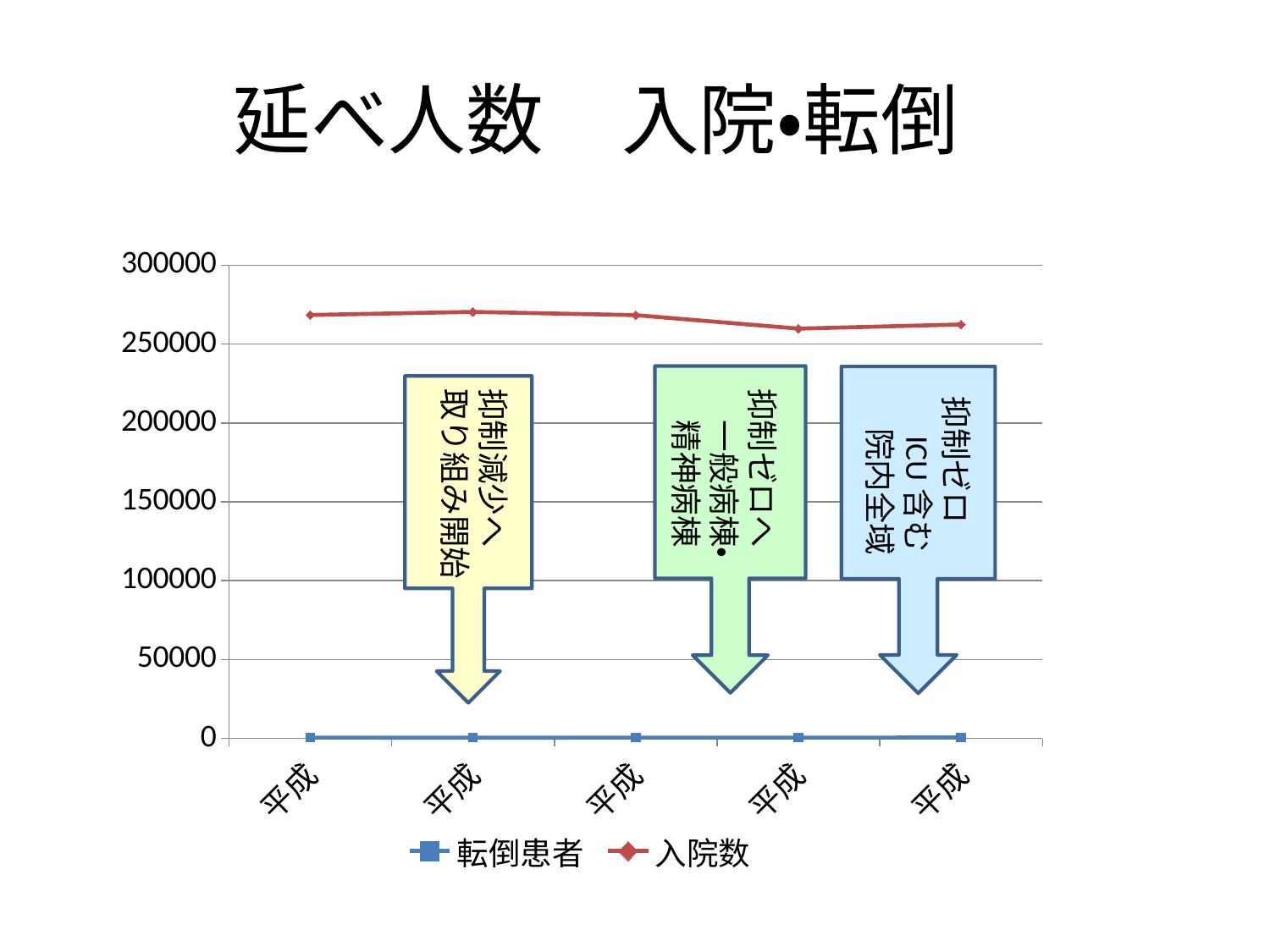
Is the value of 入院数 at the first point greater or less than 250000? greater What are the two series named in the legend? 転倒患者 and 入院数 Is the value of 入院数 at the fourth point greater or less than 300000? less What kind of chart is shown on the slide? line chart Is the value of 転倒患者 at the third point greater or less than 50000? less Which series is plotted with red diamond markers? 入院数 What is the title of the slide? 延べ人数 入院•転倒 How many series does the legend list? 2 How many data points does each series have along the x axis? 5 Which series has the larger value at the second point, 転倒患者 or 入院数? 入院数 Which series stays near 0 across all points? 転倒患者